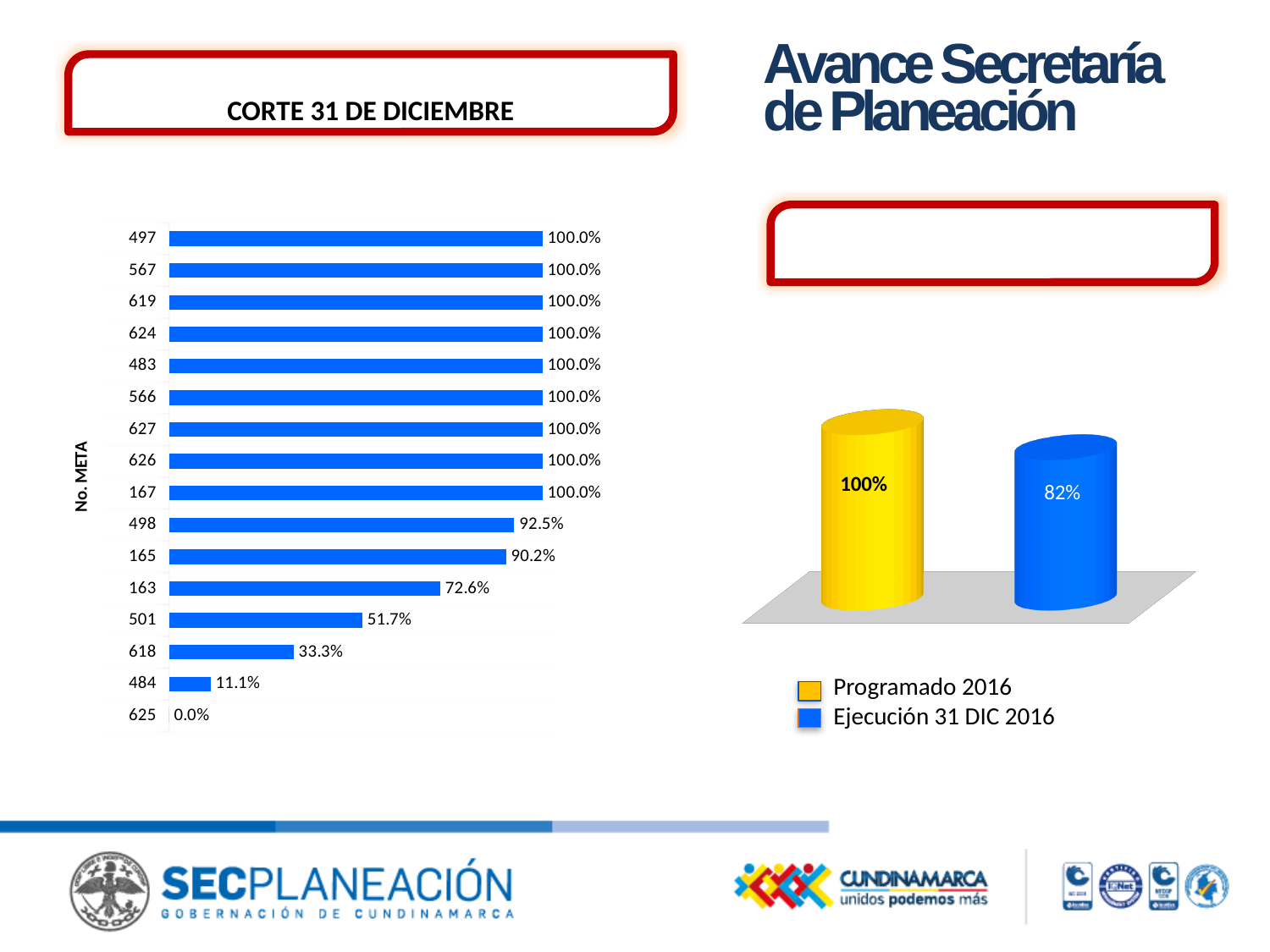
In the left bar chart, what is the value for meta 501? 51.7% How many series does the legend of the right chart list? 2 In the right chart, what is the value for Programado 2016? 100% In the right chart, what is the difference between Programado 2016 and Ejecución 31 DIC 2016? 18% What kind of chart is the left chart? bar chart In the left bar chart, which is larger, the value for meta 618 or the value for meta 501? 501 In the left bar chart, what is the value for meta 498? 92.5% In the left bar chart, which meta has the lowest value? 625 In the left bar chart, what is the value for meta 484? 11.1% In the right chart, what is the value for Ejecución 31 DIC 2016? 82% In the left bar chart, what is the difference between the values for meta 165 and meta 163? 17.6% How many metas are listed in the left bar chart? 16